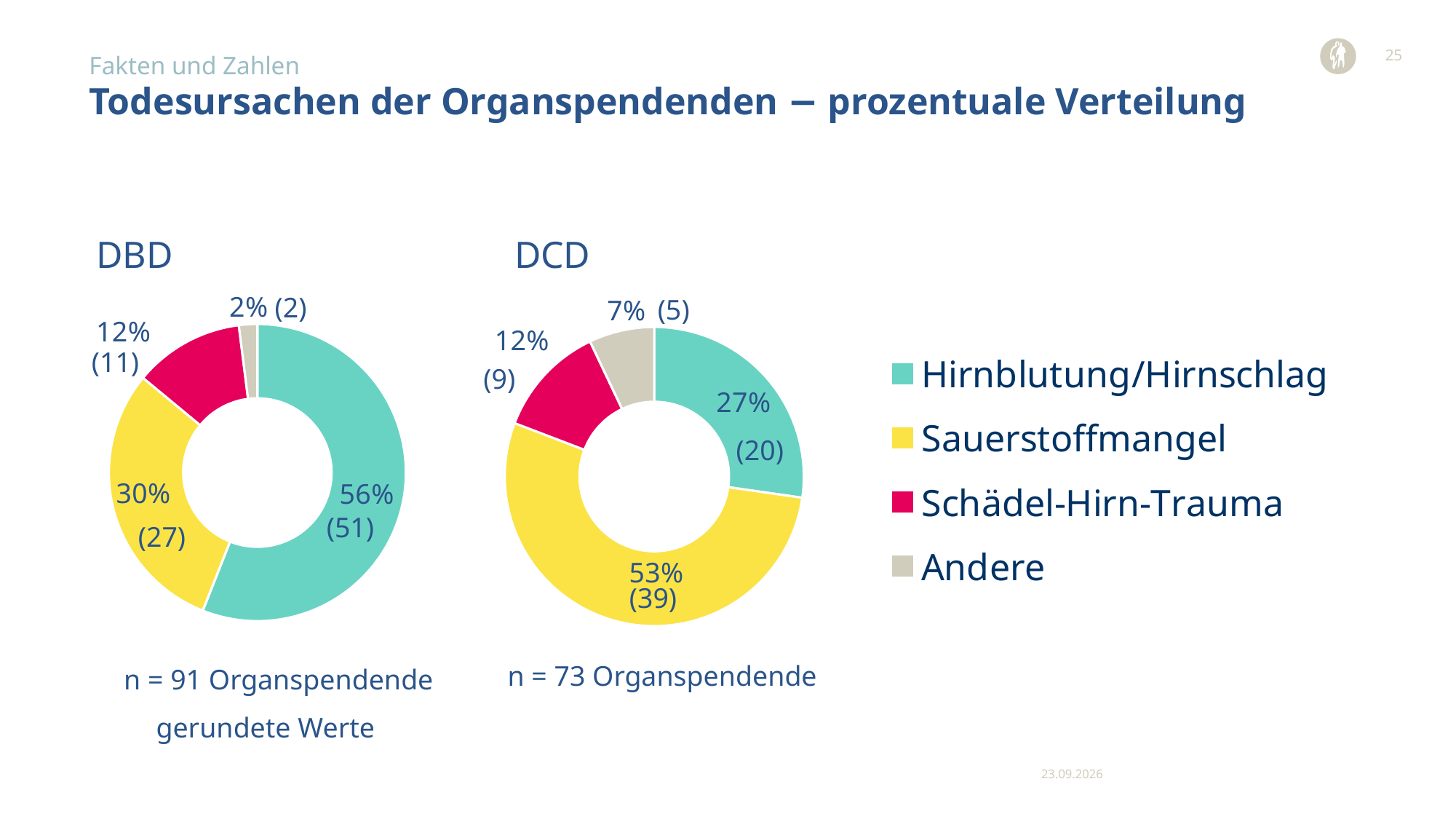
In the DBD chart, how many organ donors are in the Schädel-Hirn-Trauma category? 11 In the DCD chart, what percentage share does Sauerstoffmangel have? 53% What is the difference in percentage points between Hirnblutung/Hirnschlag in the DBD chart and in the DCD chart? 29 In the DBD chart, which category has the largest share? Hirnblutung/Hirnschlag In the DBD chart, which is larger: Sauerstoffmangel or Schädel-Hirn-Trauma? Sauerstoffmangel What is the total number of organ donors shown for the DCD chart? 73 In the DCD chart, how many organ donors are in the Andere category? 5 In the DCD chart, which category has the largest share? Sauerstoffmangel In the DBD chart, what percentage share does Hirnblutung/Hirnschlag have? 56% How many categories does the legend list? 4 What kind of chart is used for DBD and DCD? Doughnut (pie) chart In the DCD chart, which category has the smallest share? Andere